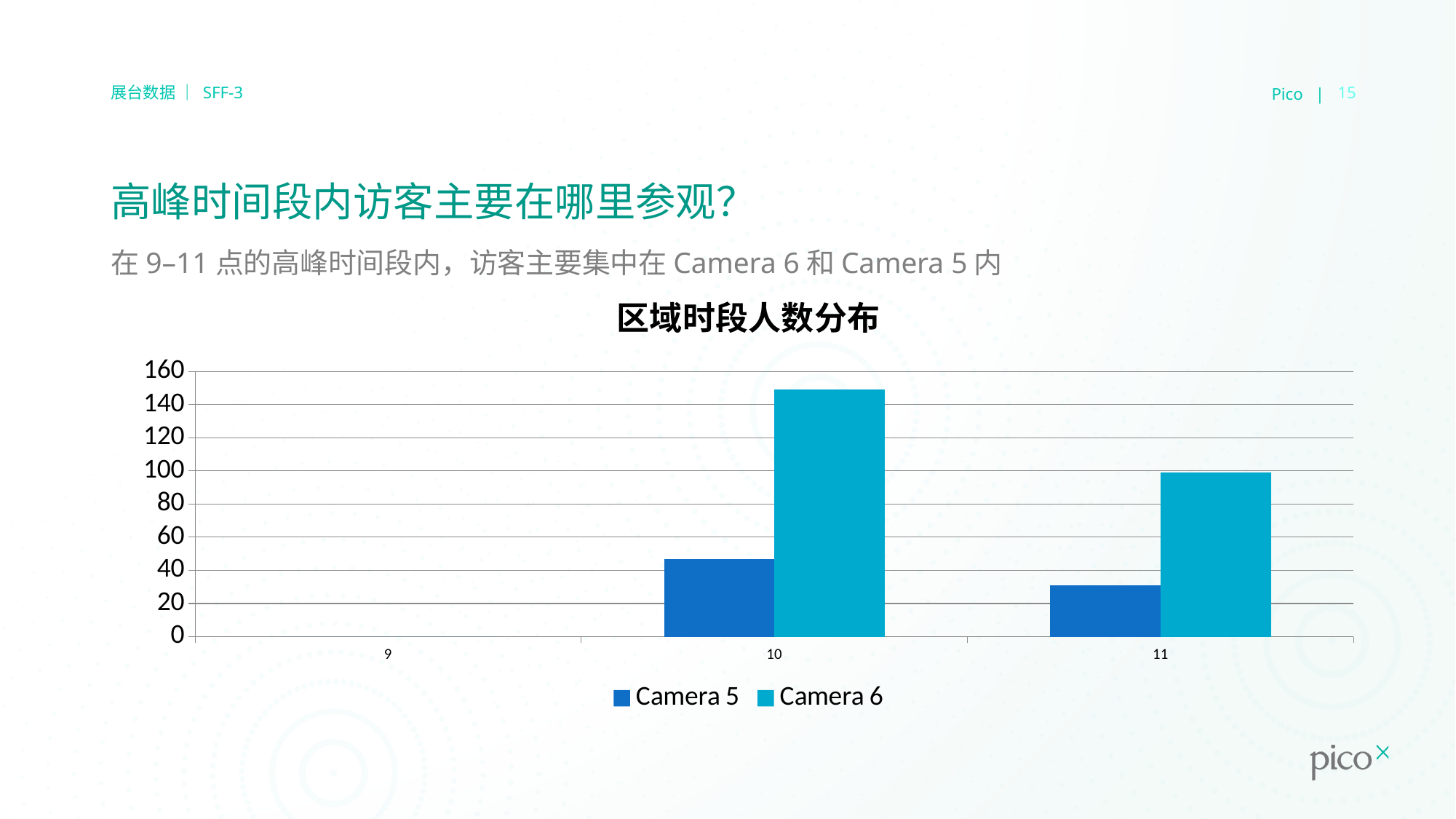
How many categories are shown on the x axis? 3 Do the Camera 6 values rise or fall from 10 to 11? fall At 10, which series has the larger value, Camera 5 or Camera 6? Camera 6 What type of chart is shown on the slide? bar chart Is the value for Camera 6 at 10 greater or less than 140? greater How many series does the legend list? 2 What is the title of the chart? 区域时段人数分布 Is the value for Camera 5 at 11 greater or less than 40? less At which x-axis category does Camera 6 reach its highest value? 10 Which series is shown in the lighter cyan colour? Camera 6 Is the value for Camera 5 at 10 greater or less than 60? less